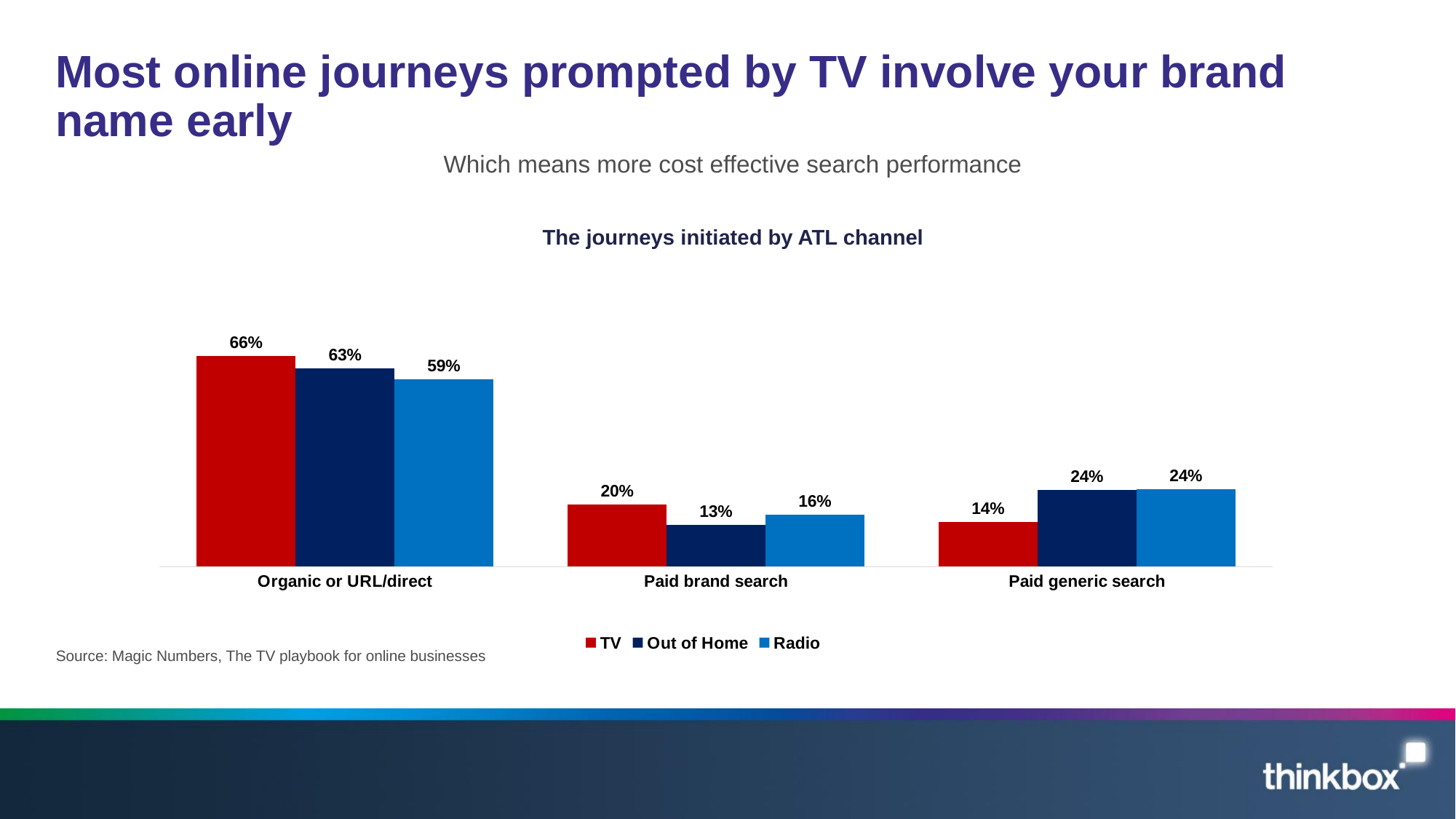
What is the value for Radio in the Paid generic search category? 24% How many categories are shown on the x axis? 3 Which category has the highest value for TV? Organic or URL/direct What is the title of the chart? The journeys initiated by ATL channel Which category has the lowest value for Radio? Paid brand search What is the value for TV in the Organic or URL/direct category? 66% Which is larger in the Paid generic search category: TV or Out of Home? Out of Home What kind of chart is shown on the slide? Bar chart What is the difference between the TV and Radio values in the Organic or URL/direct category? 7% What is the value for Out of Home in the Paid brand search category? 13% How many series does the legend list? 3 Which series is shown in red? TV